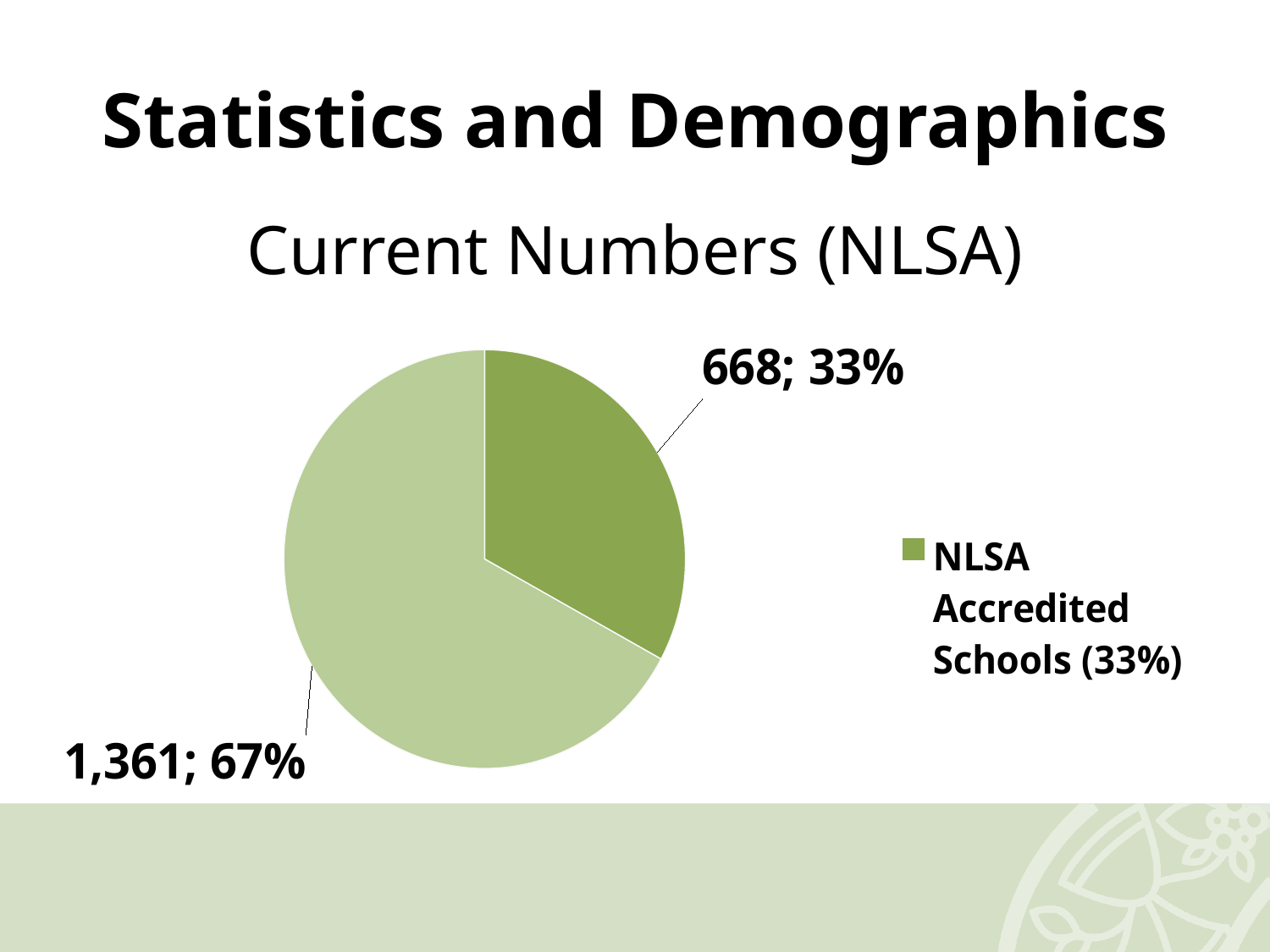
What kind of chart is shown on the slide? pie chart Is the value for NLSA Accredited Schools greater or less than 1,000? less What share of the pie does the NLSA Accredited Schools slice represent? 33% What is the value shown for NLSA Accredited Schools in the pie chart? 668 What legend entry is shown for the pie chart? NLSA Accredited Schools (33%) How many slices does the pie chart have? 2 What share of the pie does the larger, lighter green slice represent? 67% Which slice is larger: the NLSA Accredited Schools slice or the lighter green slice? the lighter green slice What is the difference between the two slice values in the pie chart (1,361 and 668)? 693 What is the value shown for the larger, lighter green slice of the pie chart? 1,361 What is the title of the pie chart? Current Numbers (NLSA) What is the total of the two slice values in the pie chart? 2,029